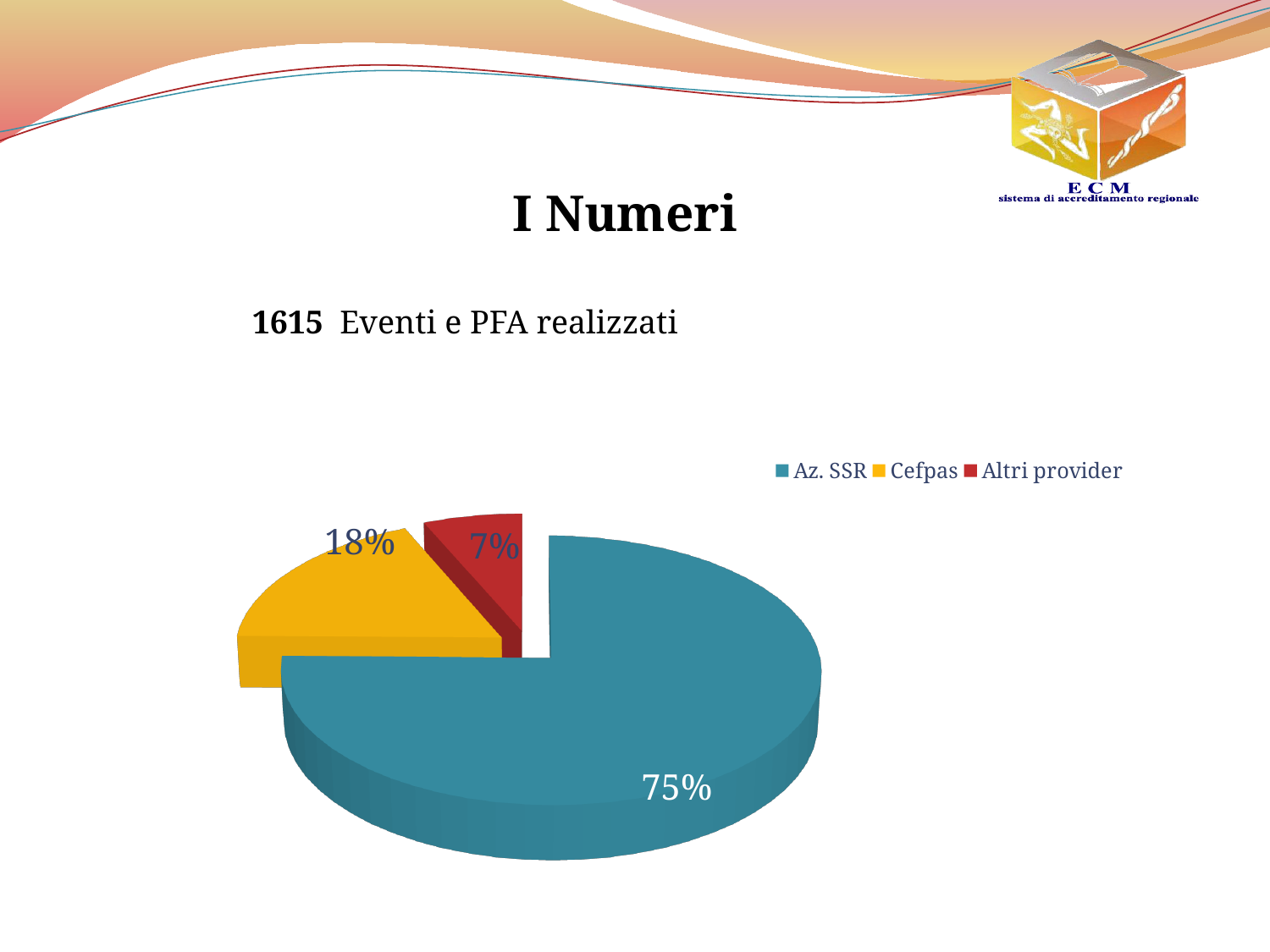
What total number of events and PFA realised is stated above the chart? 1615 Which category has the largest slice of the pie chart? Az. SSR What percentage of the pie chart does Altri provider account for? 7% What percentage of the pie chart does Az. SSR account for? 75% What colour is the Az. SSR slice in the pie chart? teal blue What kind of chart is shown on the slide? pie chart How many slices does the pie chart have? 3 How many entries does the legend list? 3 What is the difference in percentage points between the Az. SSR slice and the Cefpas slice? 57 What percentage of the pie chart does Cefpas account for? 18% Which category has the smallest slice of the pie chart? Altri provider Which slice is larger, Cefpas or Altri provider? Cefpas